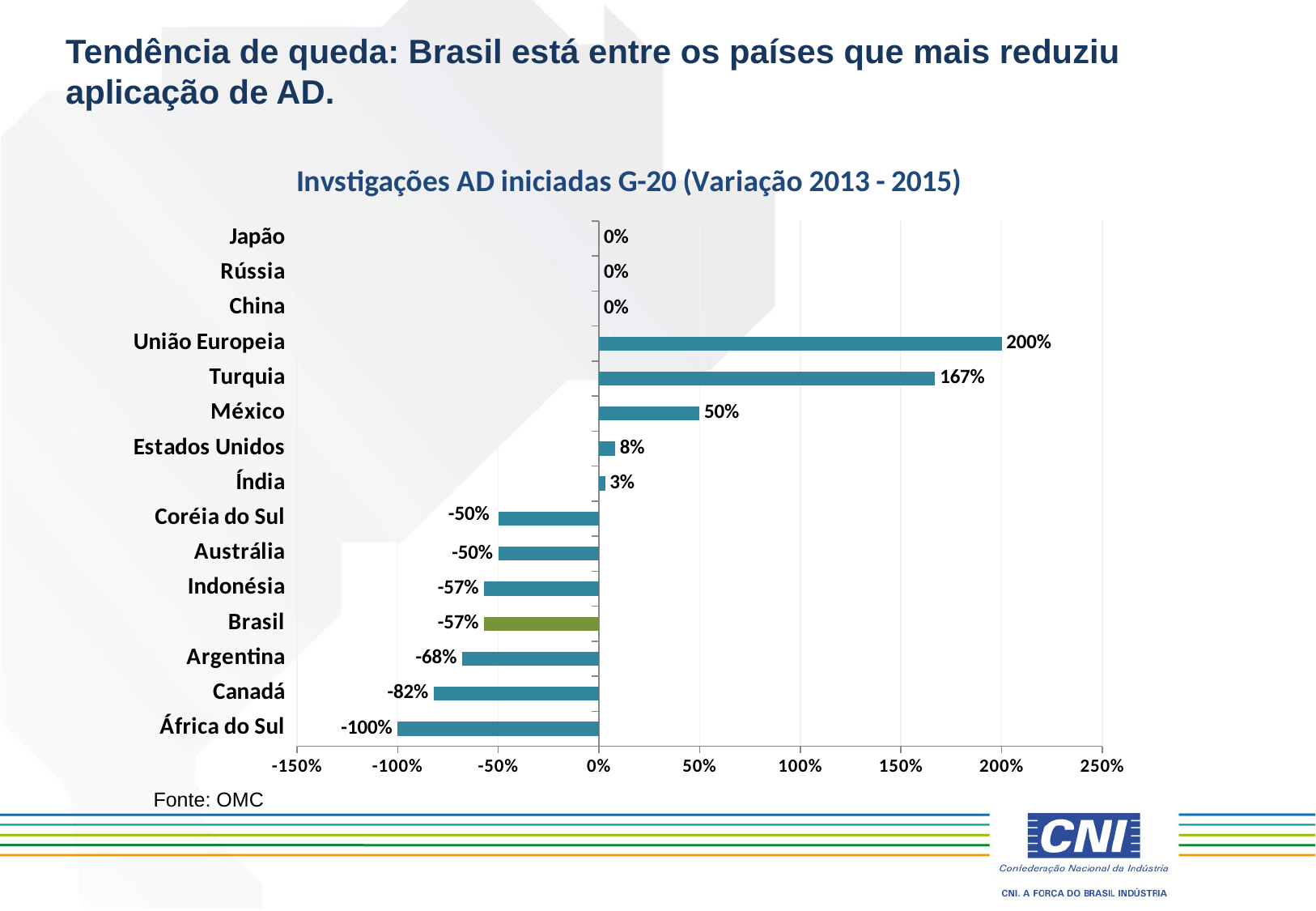
What is the value for União Europeia? 200% What is the value for Brasil? -57% Which country has the lowest value? África do Sul How many countries are shown in the chart? 15 What is the difference between the values for União Europeia and Turquia? 33 percentage points What is the title of the chart? Invstigações AD iniciadas G-20 (Variação 2013 - 2015) What type of chart is shown on the slide? Bar chart Which country's bar is coloured green instead of blue? Brasil Which country has the highest value? União Europeia Which has the larger value, Argentina or Canadá? Argentina What is the value for Canadá? -82% What is the value for Turquia? 167%